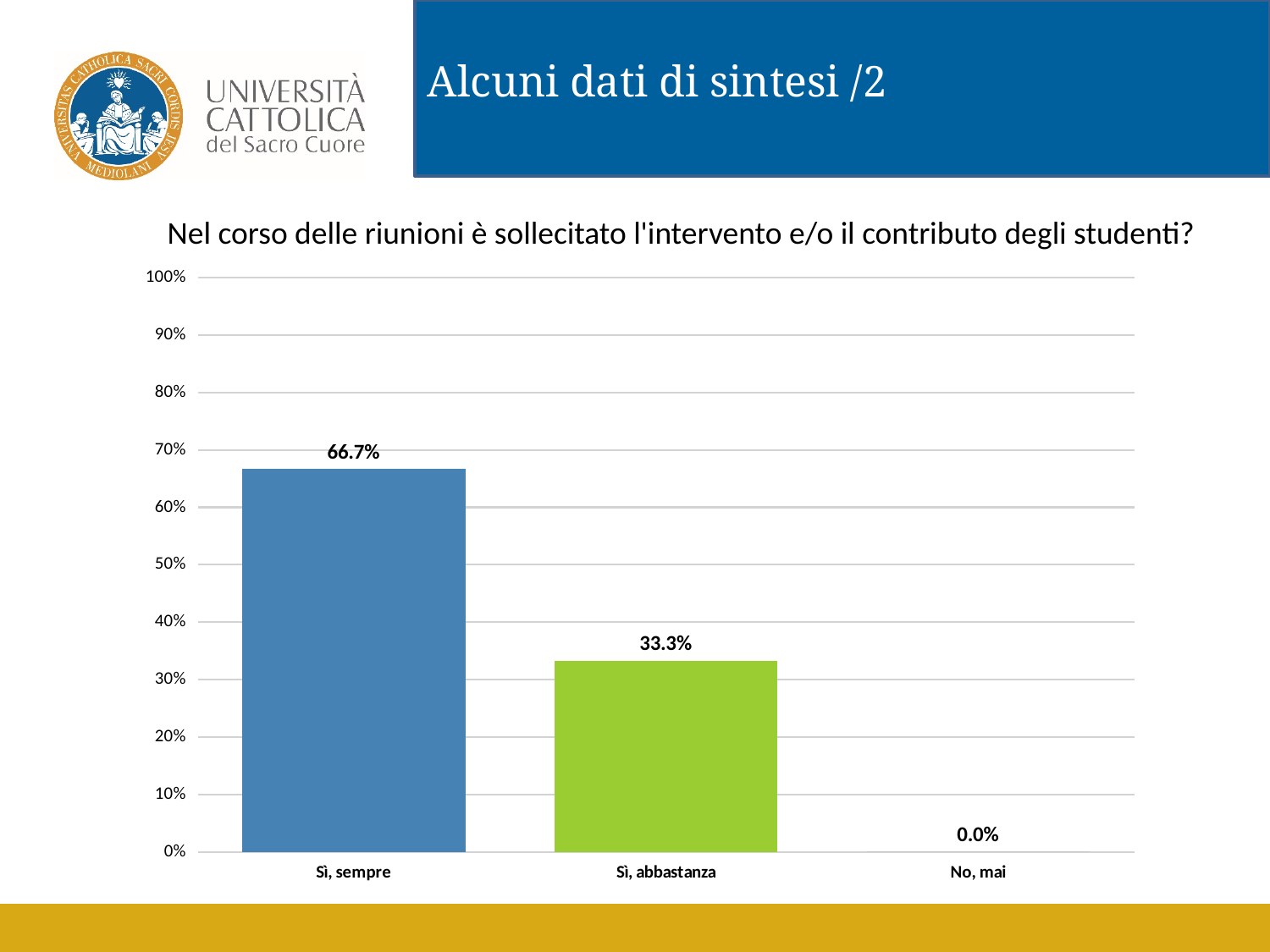
What is the value for "Sì, abbastanza"? 33.3% Which category has the highest value? Sì, sempre What is the difference between the values for "Sì, sempre" and "Sì, abbastanza"? 33.4% Which category has the lowest value? No, mai Is the value for "Sì, sempre" greater or less than 60%? greater Do the values rise or fall from left to right along the x axis? fall What is the value for "No, mai"? 0.0% Is the value for "Sì, abbastanza" greater or less than 40%? less Which is larger, the value for "Sì, abbastanza" or the value for "No, mai"? Sì, abbastanza How many categories are shown on the x axis? 3 What is the value for "Sì, sempre"? 66.7% What kind of chart is shown on the slide? bar chart